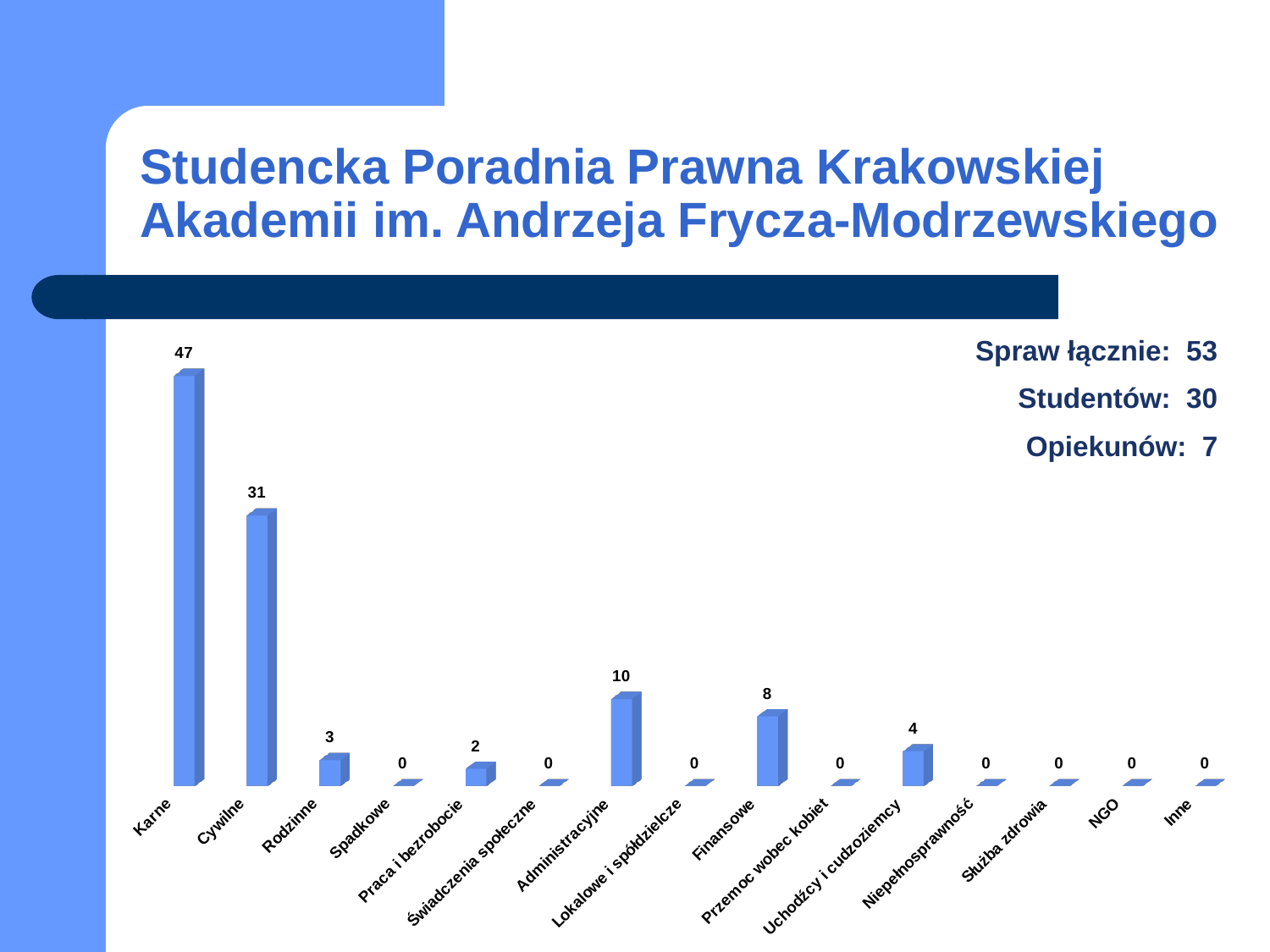
Which category has the highest value? Karne What is the value for Administracyjne? 10 How many categories have a value of 0? 8 What kind of chart is shown on the slide? Bar chart How many categories are shown on the x axis of the chart? 15 What is the difference between the values for Karne and Cywilne? 16 Which is larger, the value for Administracyjne or the value for Finansowe? Administracyjne What is the value for Uchodźcy i cudzoziemcy? 4 What is the value for Cywilne? 31 What is the value for Karne? 47 What is the value for Rodzinne? 3 What is the value for Finansowe? 8